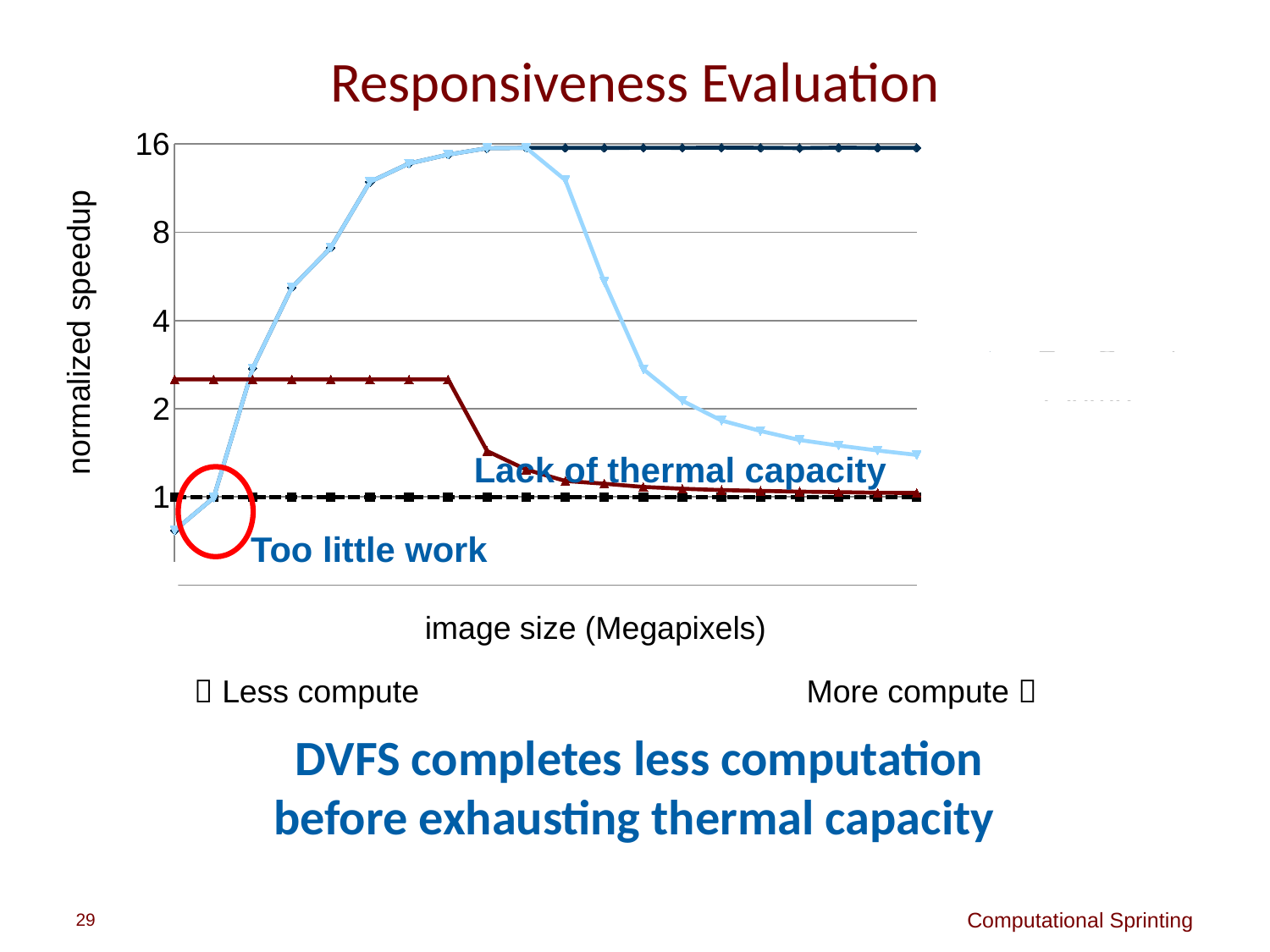
Does the dark red line rise or fall as image size increases? fall What is the label of the x axis? image size (Megapixels) Is the value of the dark red line at the left side of the chart greater or less than 4? less What is the label of the y axis? normalized speedup What kind of chart is shown on the slide? line chart Is the value of the light blue line at the right end of the chart greater or less than 2? less At the right end of the chart, which is larger: the light blue line or the dark red line? light blue line Does the light blue line rise or fall as image size increases beyond its peak? fall How many lines are plotted on the chart? 4 Is the value of the dark red line at the left side of the chart greater or less than 2? greater At what normalized speedup does the black dashed line sit across the whole chart? 1